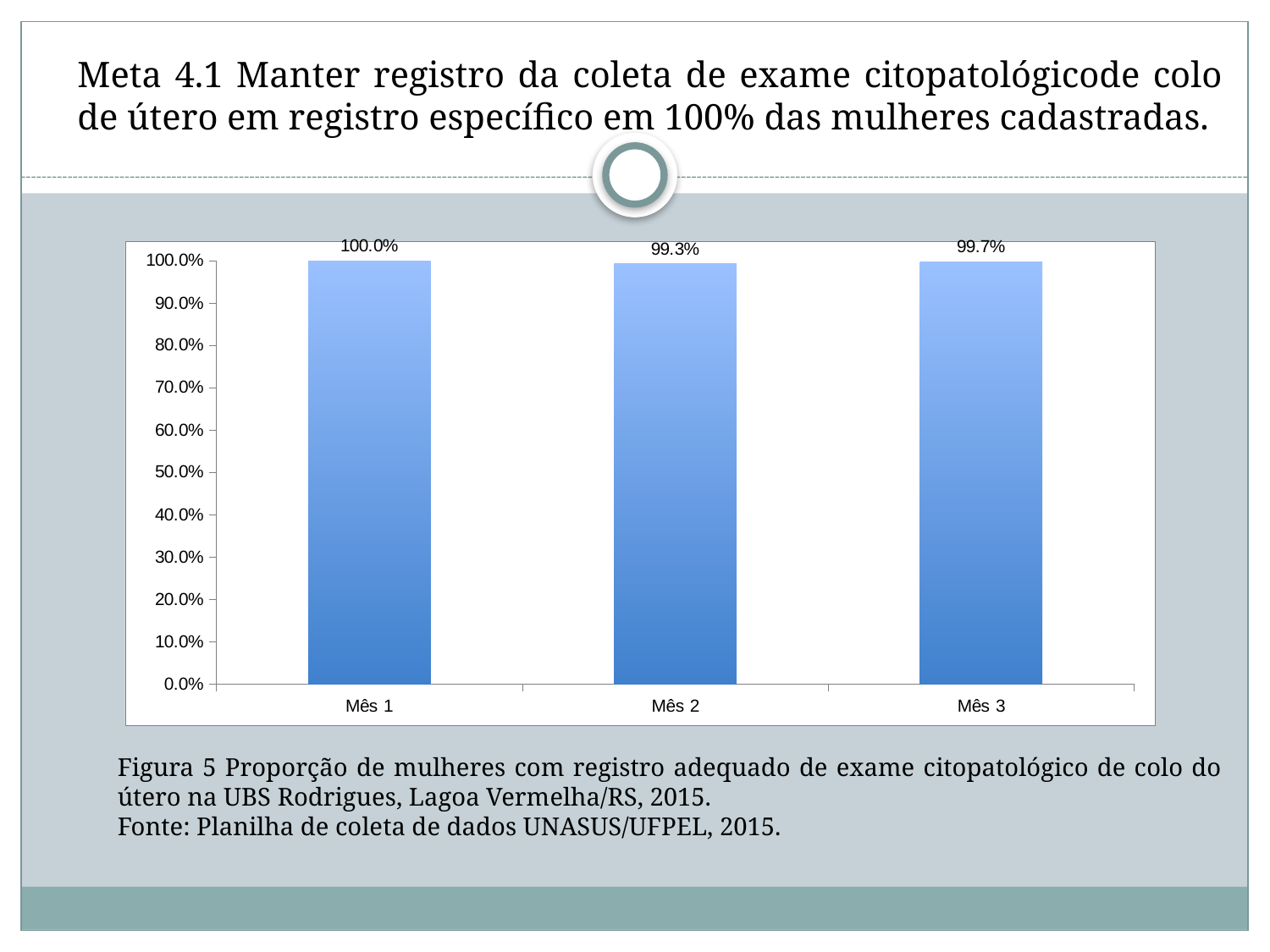
What is the difference between the values for Mês 3 and Mês 2? 0.4% Which month has the highest value? Mês 1 Which month has the lowest value? Mês 2 What kind of chart is shown on the slide? bar chart What is the value for Mês 2? 99.3% Which is larger, the value for Mês 2 or the value for Mês 3? Mês 3 What is the difference between the values for Mês 1 and Mês 2? 0.7% What is the value for Mês 1? 100.0% Is the value for Mês 2 greater or less than 90.0%? greater How many months are shown on the x axis? 3 What is the value for Mês 3? 99.7% What is the highest tick value shown on the y axis? 100.0%